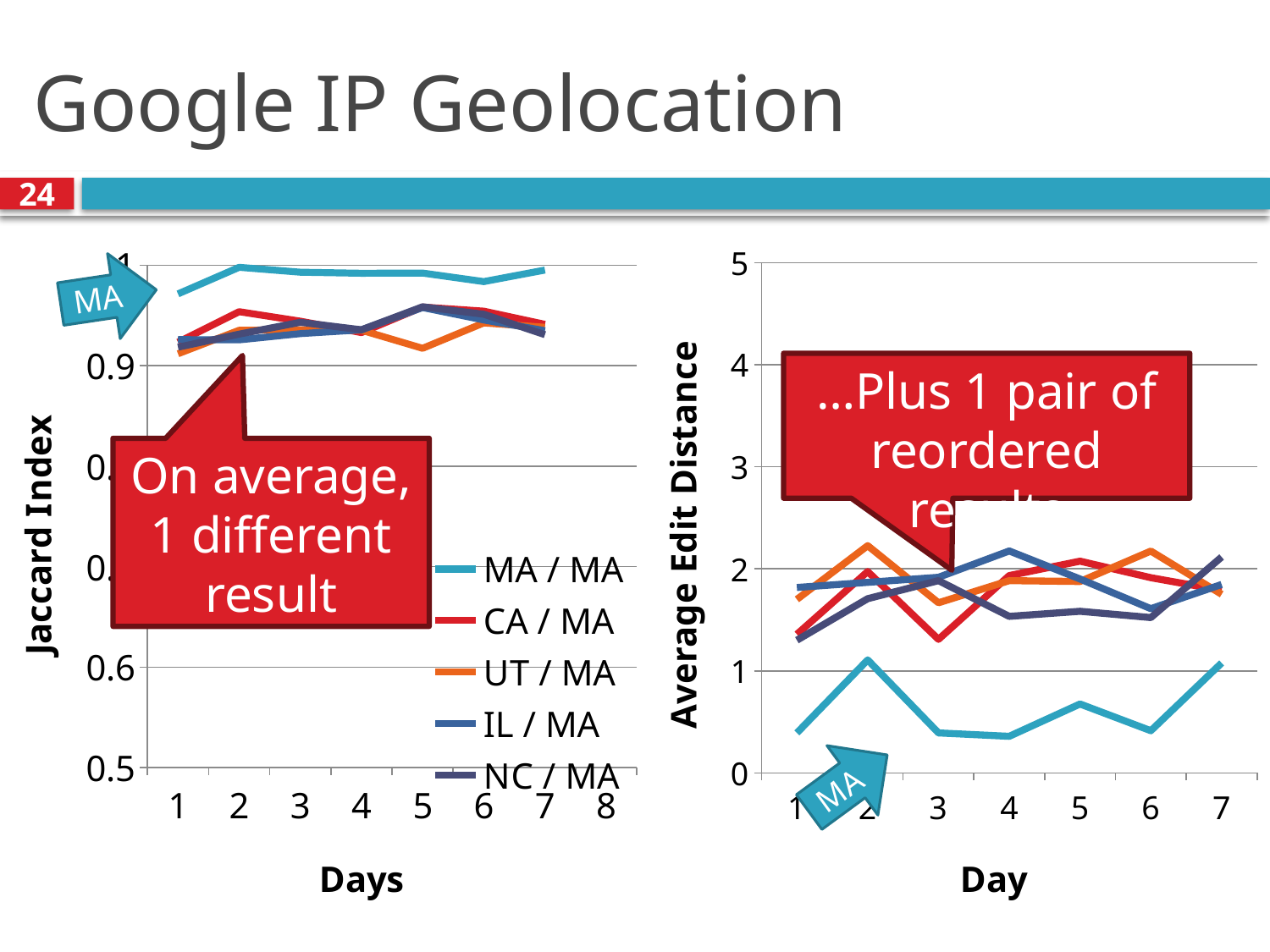
What is the y-axis label of the right chart? Average Edit Distance On the right chart, how many days are shown on the x axis? 7 On the left chart, which series has the highest Jaccard Index across the days? MA / MA On the left chart, is the Jaccard Index for UT / MA on day 5 greater or less than 0.9? greater How many series does the legend of the left chart list? 5 On the left chart, which is larger on day 1: the Jaccard Index for MA / MA or for CA / MA? MA / MA What kind of chart is the left chart (Jaccard Index)? line chart On the right chart, is the Average Edit Distance for the line marked MA on day 3 greater or less than 1? less On the left chart, is the Jaccard Index for MA / MA on day 2 greater or less than 0.9? greater What is the x-axis label of the left chart? Days What kind of chart is the right chart (Average Edit Distance)? line chart